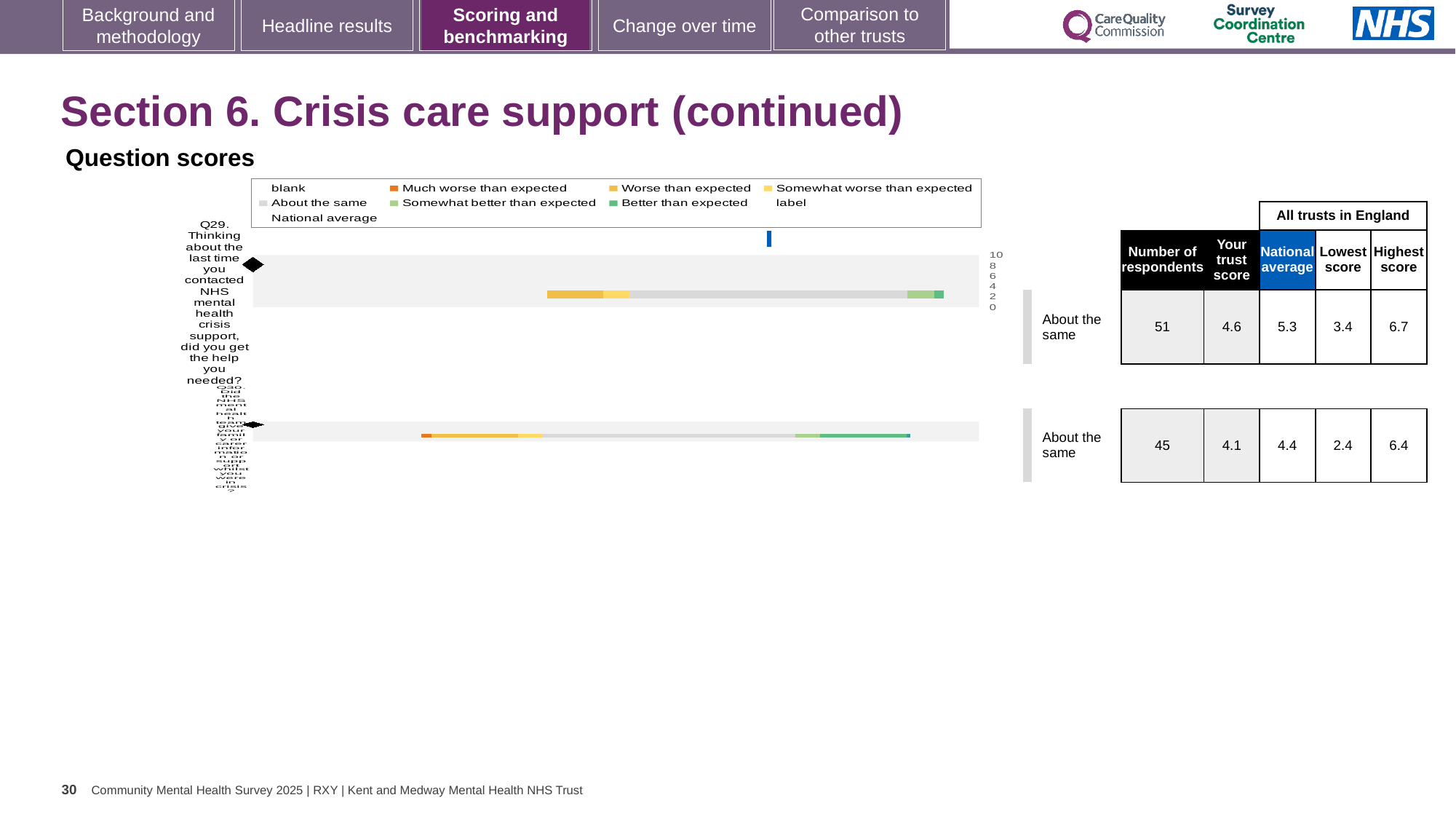
Which is larger for Q29: the trust's score or the national average? National average Which legend entry in the question scores chart is shown in orange? Much worse than expected What is the national average for Q29 in the question scores table? 5.3 What benchmark category is shown for Q30 in the question scores chart? About the same How many more respondents answered Q29 than Q30? 6 What is the number of respondents for Q29 in the question scores table? 51 What is the highest score across all trusts in England for Q30? 6.4 How many entries does the legend of the question scores chart list? 9 What is the difference between the highest and lowest scores for Q29? 3.3 What is the trust's score for Q30 in the question scores table? 4.1 How many questions (categories) are plotted in the question scores chart? 2 What kind of chart is used to show the question scores on this slide? bar chart